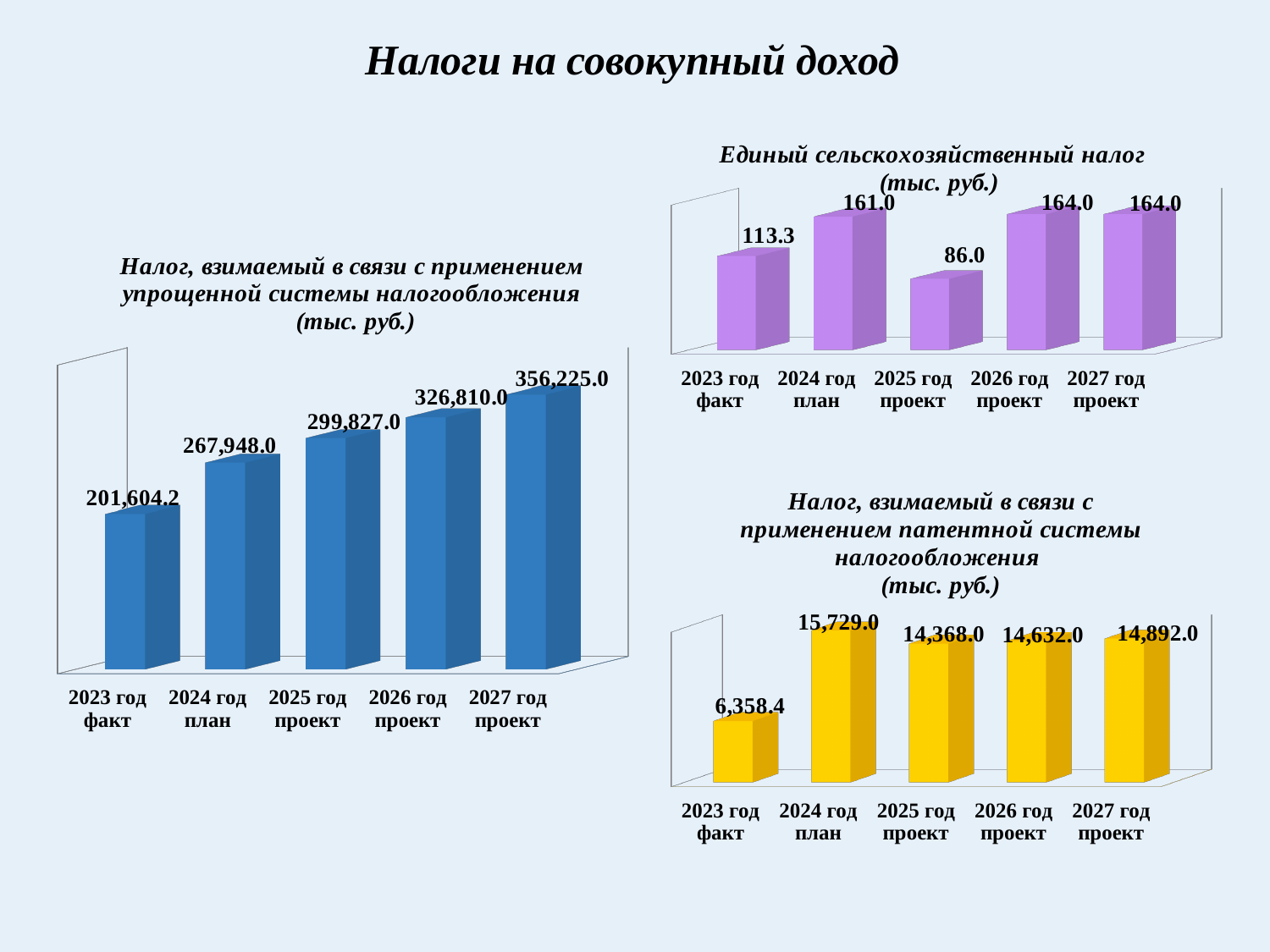
In the top-right chart (Единый сельскохозяйственный налог), what is the value for 2025 год проект? 86.0 In the chart on the left (simplified taxation system), what is the value for 2024 год план? 267,948.0 In the bottom-right chart (patent taxation system), what is the value for 2023 год факт? 6,358.4 In the chart on the left (simplified taxation system), which category has the highest value? 2027 год проект In the chart on the left (simplified taxation system), do the values rise or fall from 2023 to 2027? rise In the bottom-right chart (patent taxation system), what is the difference between the 2024 год план and 2023 год факт values? 9,370.6 In the top-right chart (Единый сельскохозяйственный налог), what is the difference between the 2026 год проект and 2025 год проект values? 78.0 In the bottom-right chart (patent taxation system), which category has the highest value? 2024 год план In the top-right chart (Единый сельскохозяйственный налог), which is larger: the value for 2023 год факт or 2024 год план? 2024 год план In the chart on the left (simplified taxation system), what is the difference between the 2027 год проект and 2023 год факт values? 154,620.8 In the top-right chart (Единый сельскохозяйственный налог), which category has the lowest value? 2025 год проект How many categories does the bottom-right chart (patent taxation system) show? 5